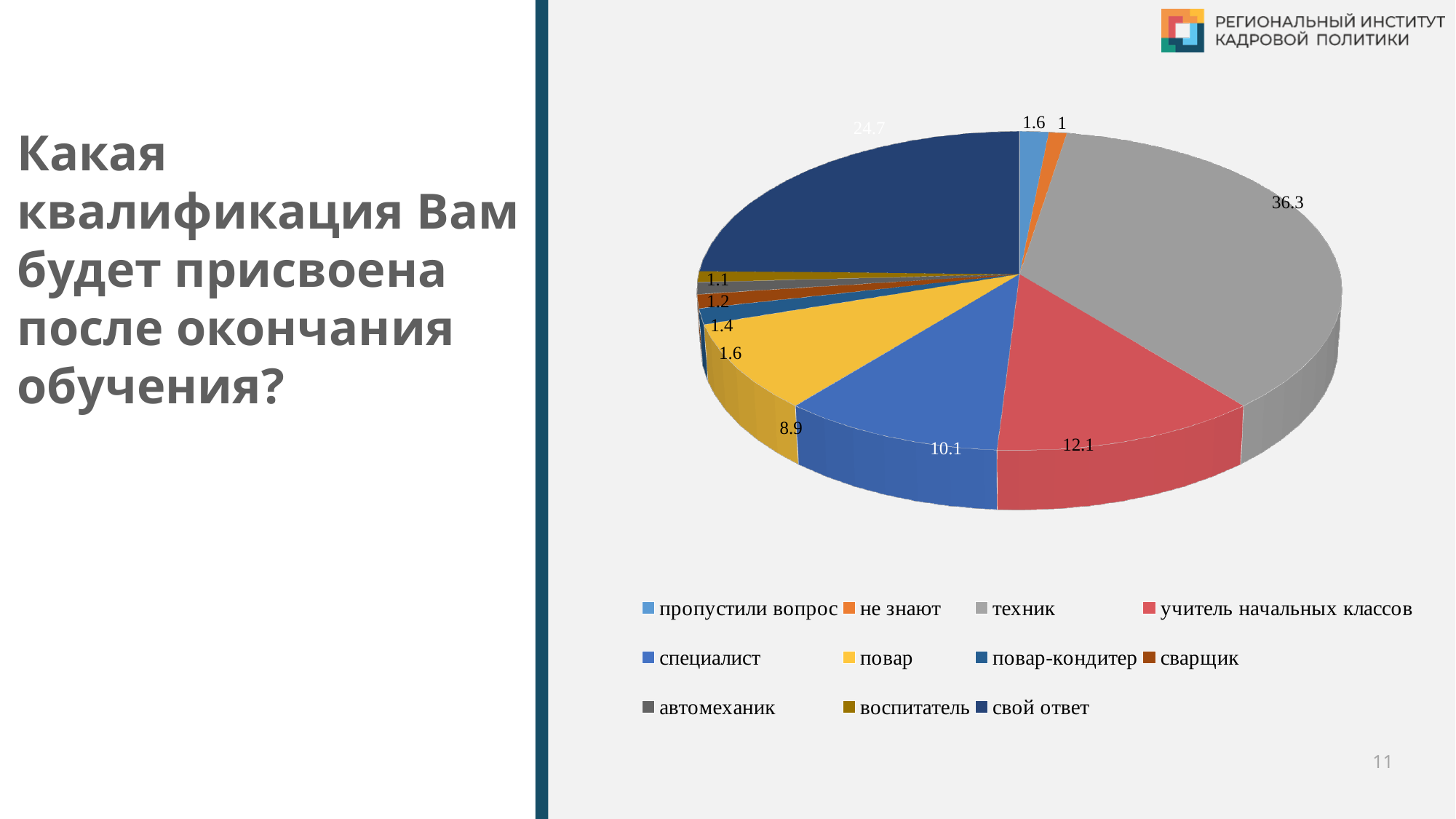
What is the value for повар? 8.9 Which category has the smallest slice? не знают Which is larger, специалист or повар? специалист What is the value for техник? 36.3 What is the value for специалист? 10.1 What is the difference between the values for техник and свой ответ? 11.6 What kind of chart is shown on the slide? pie chart How many categories does the legend list? 11 Which category has the largest slice? техник What is the value for учитель начальных классов? 12.1 What is the value for свой ответ? 24.7 What is the value for не знают? 1